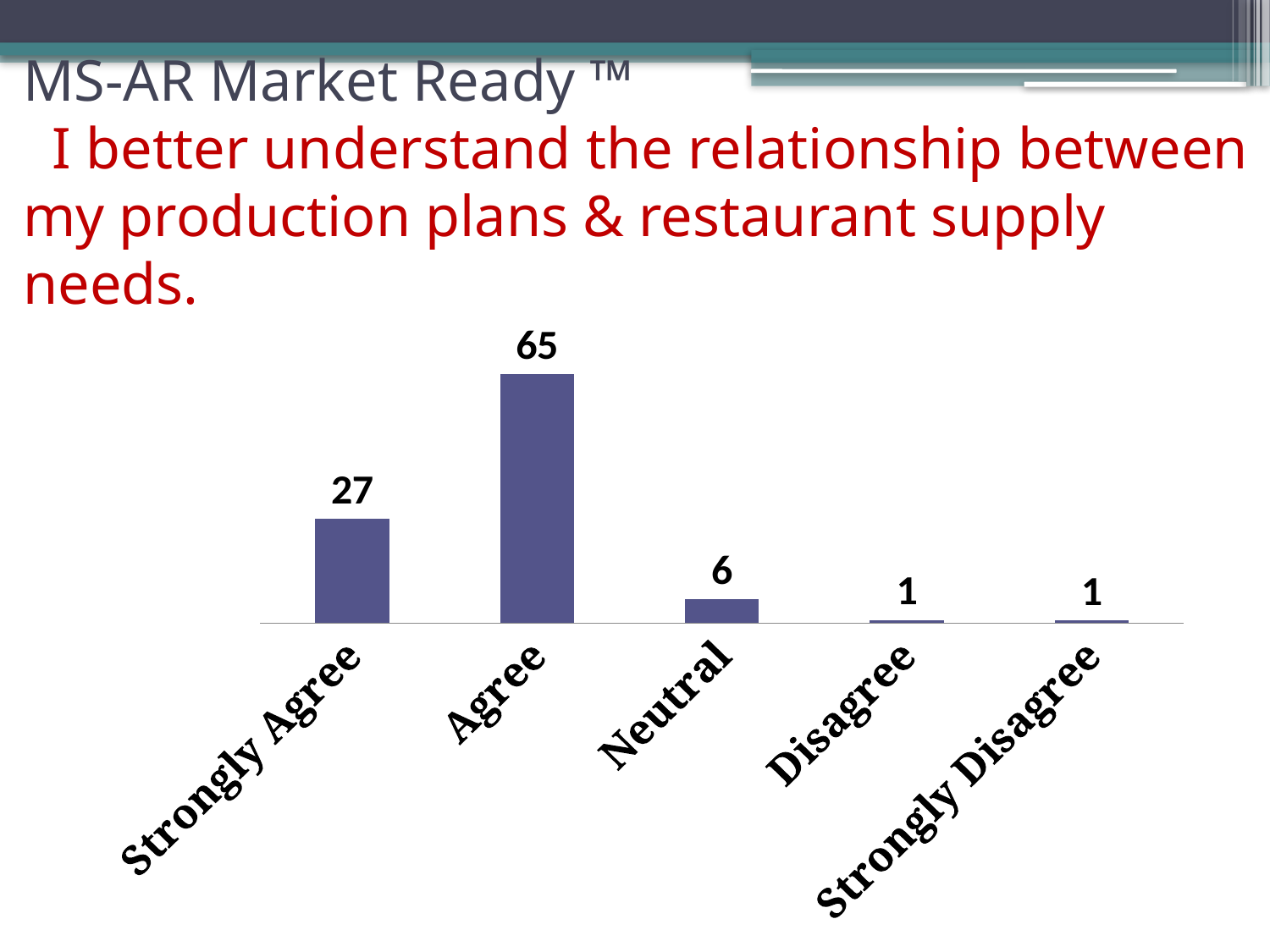
What is the value for Agree? 65 What is the total of the values for Disagree and Strongly Disagree? 2 What is the difference between the values for Strongly Agree and Neutral? 21 How many categories are shown on the x axis? 5 Which is larger, the value for Strongly Agree or the value for Neutral? Strongly Agree What is the value for Disagree? 1 Do the values rise or fall from Agree to Strongly Disagree along the x axis? Fall What kind of chart is shown on the slide? Bar chart What is the value for Strongly Agree? 27 Which category has the highest value? Agree What is the value for Neutral? 6 What is the difference between the values for Agree and Strongly Agree? 38